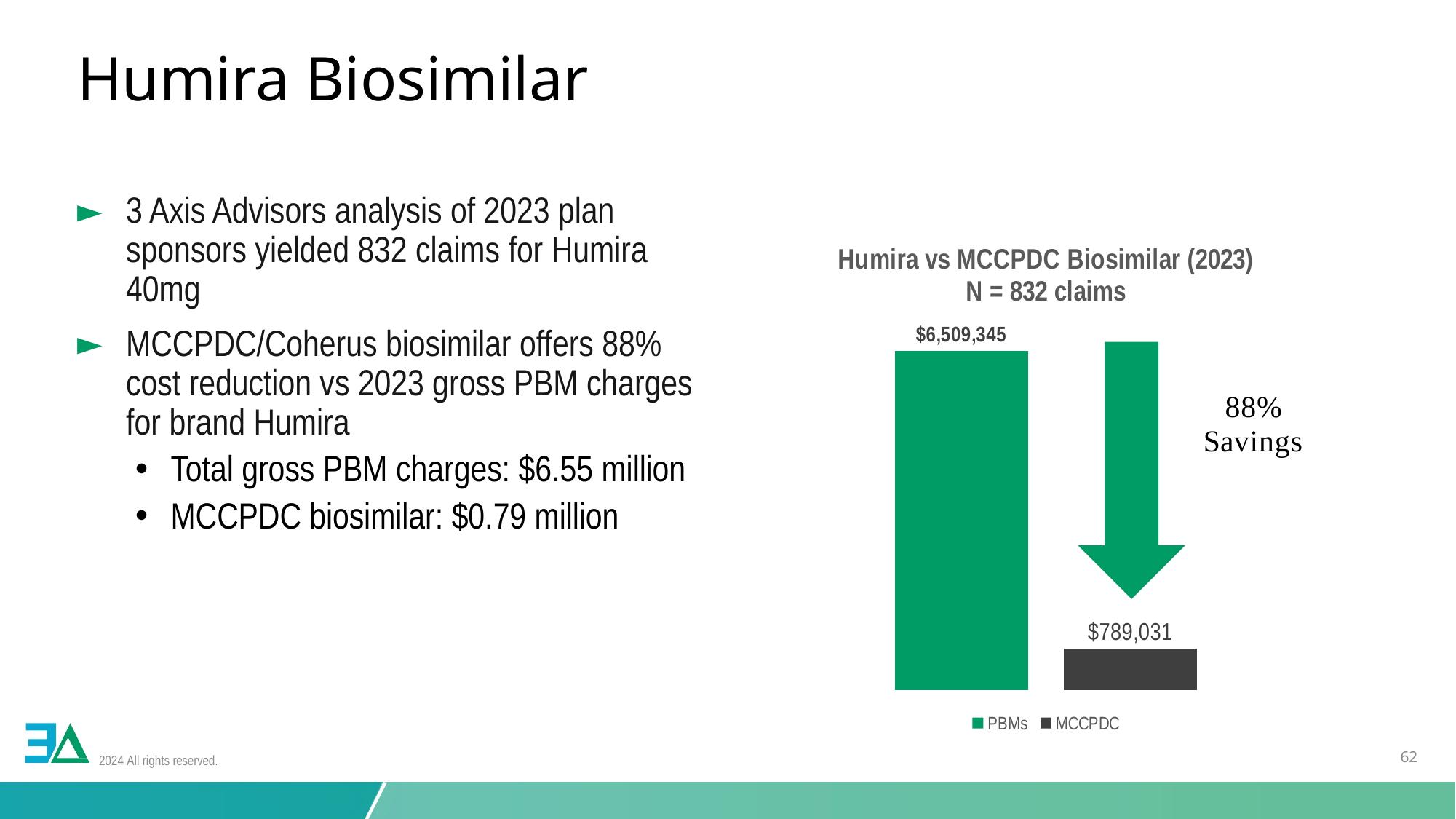
What is the value for MCCPDC in the chart? $789,031 Which series has the lower value in the chart? MCCPDC How many series does the legend list? 2 Is the value for MCCPDC larger or smaller than the value for PBMs? smaller Which series has the higher value, PBMs or MCCPDC? PBMs What percentage savings is annotated next to the arrow in the chart? 88% Savings What is the title of the chart? Humira vs MCCPDC Biosimilar (2023) N = 832 claims What kind of chart is shown on the slide? bar chart How many bars are plotted in the chart? 2 What is the difference between the PBMs value and the MCCPDC value? $5,720,314 What is the value for PBMs in the chart? $6,509,345